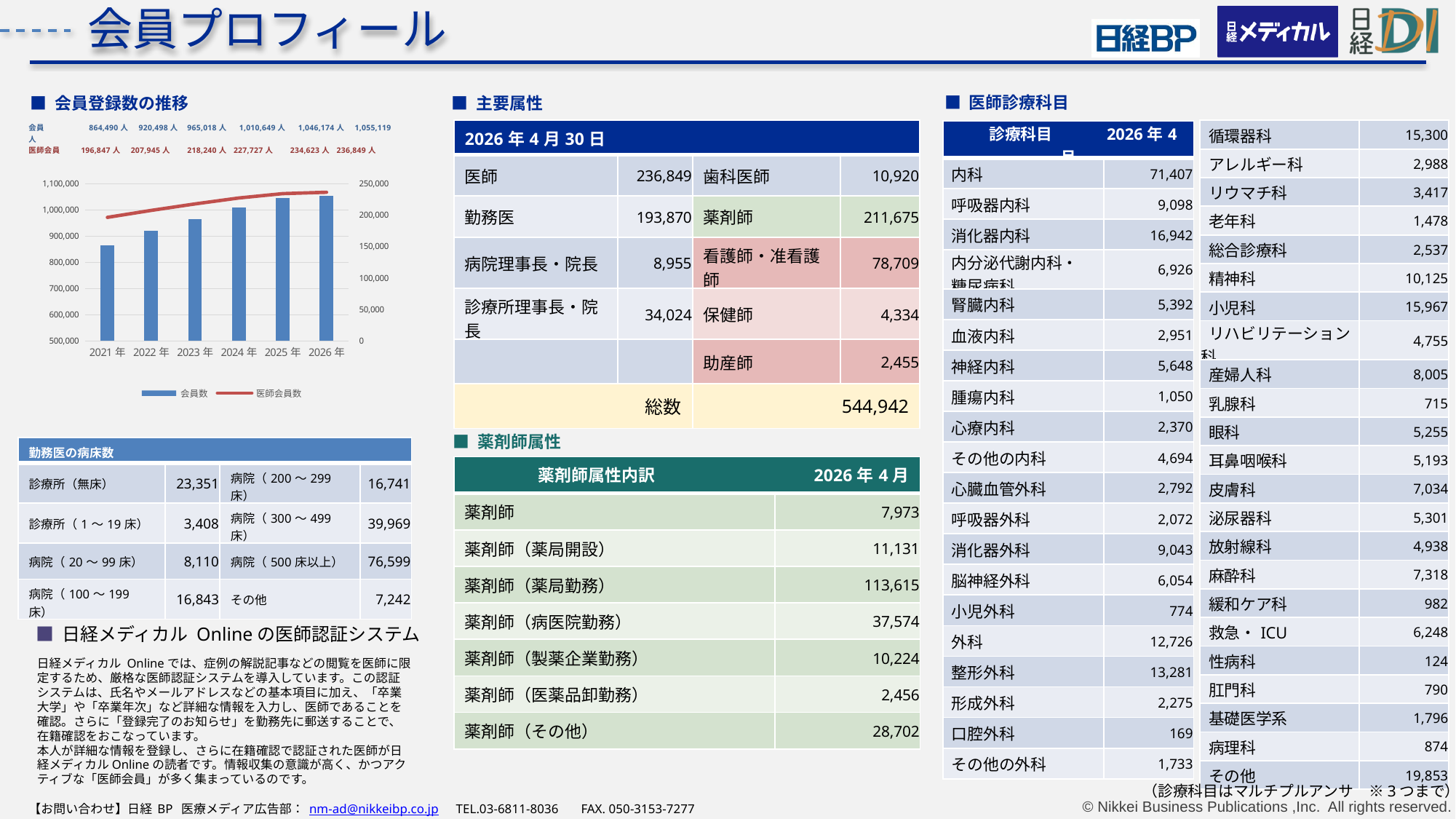
In the 会員登録数の推移 chart, is the 会員数 bar for 2023年 greater or less than 1,000,000? less In the 会員登録数の推移 chart, how many years are shown on the x axis? 6 In the 会員登録数の推移 chart, what is the difference between the 会員 values for 2026年 and 2025年? 8,945人 In the 会員登録数の推移 chart, which series is drawn as a line? 医師会員数 In the 会員登録数の推移 chart, which year has the highest 会員数 bar? 2026年 In the 会員登録数の推移 chart, what is the 会員 value for 2021年? 864,490人 In the 会員登録数の推移 chart, what is the 会員 value for 2024年? 1,010,649人 In the 会員登録数の推移 chart, what is the 医師会員 value for 2026年? 236,849人 In the 会員登録数の推移 chart, which year has the lowest 会員数 bar? 2021年 In the 会員登録数の推移 chart, do the 会員数 bars rise or fall from 2021年 to 2026年? Rise In the 会員登録数の推移 chart, how many series does the legend list? 2 What kind of chart is shown under 会員登録数の推移? A combined bar and line chart